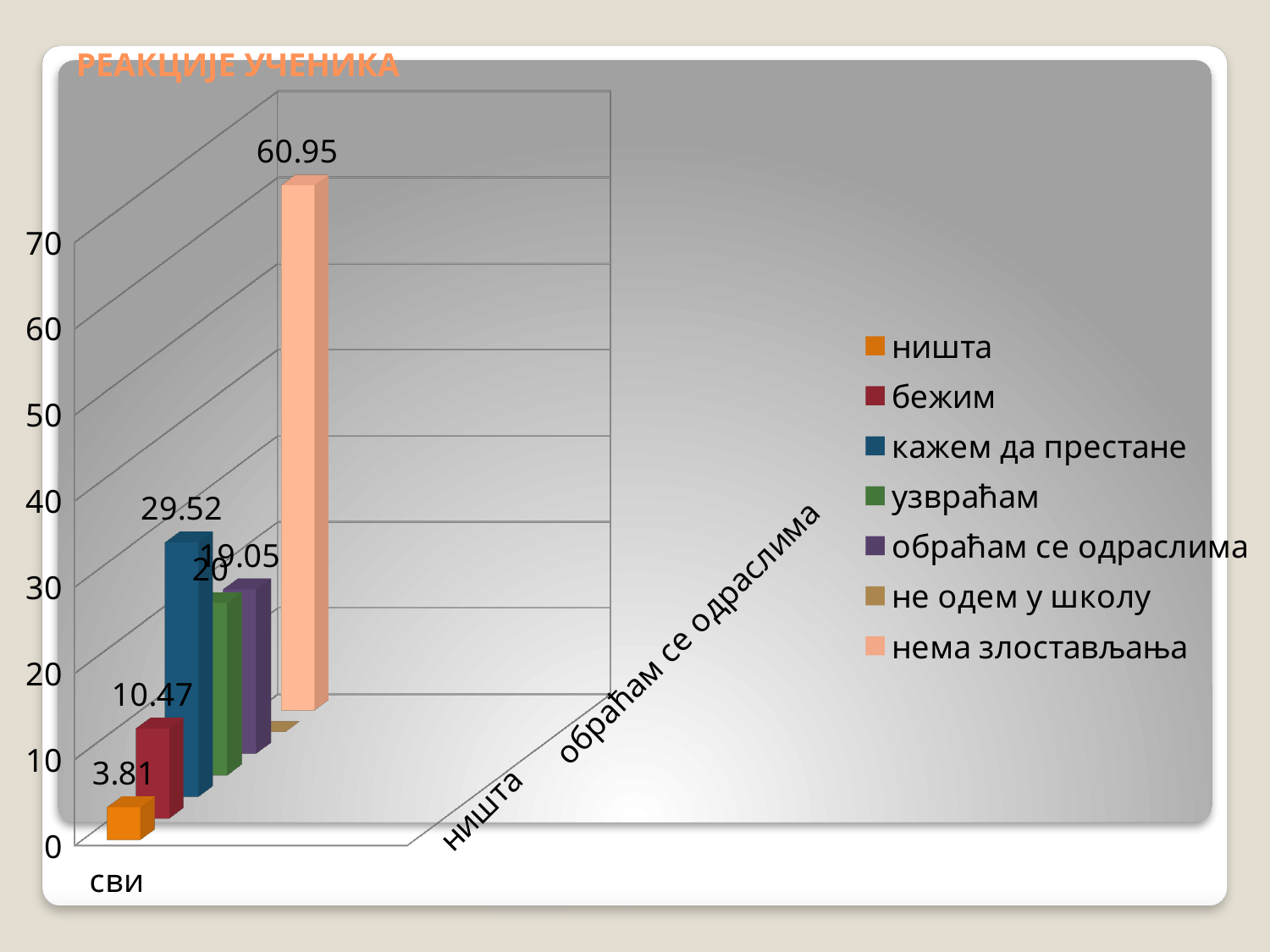
What is the difference between the values for 'нема злостављања' and 'кажем да престане'? 31.43 Which is larger, the value for 'бежим' or the value for 'узвраћам'? узвраћам What is the label of the category on the x axis? сви What is the value for 'бежим'? 10.47 What type of chart is shown on the slide? bar chart What is the value for 'нема злостављања'? 60.95 What is the value for 'ништа'? 3.81 How many series does the legend list? 7 What is the title of the chart? РЕАКЦИЈЕ УЧЕНИКА What is the value for 'кажем да престане'? 29.52 Which series has the highest value? нема злостављања What is the value for 'узвраћам'? 20